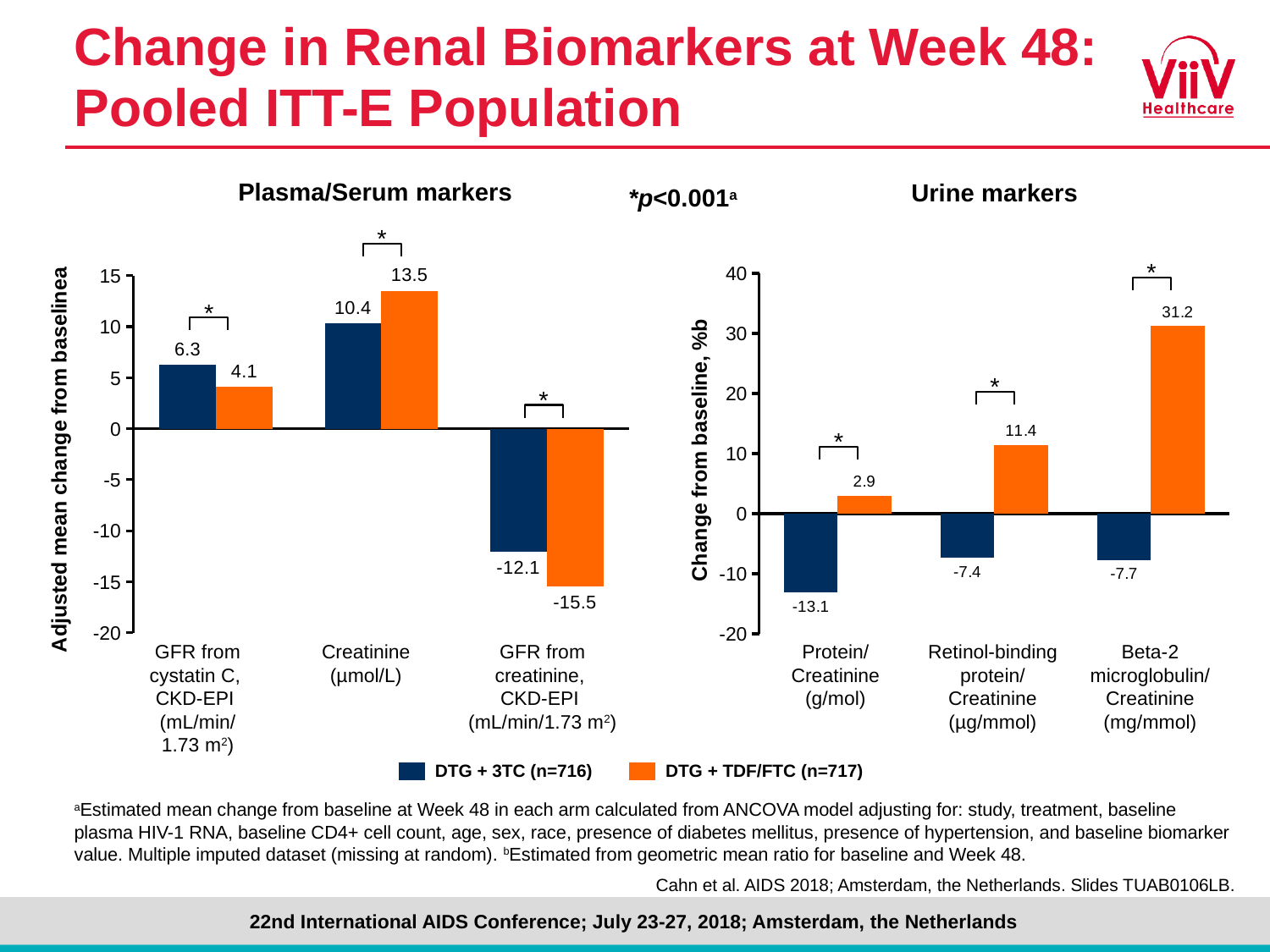
How many markers are shown on the x axis of the Urine markers chart? 3 In the Plasma/Serum markers chart, which marker has the lowest value for the DTG + TDF/FTC arm? GFR from creatinine, CKD-EPI In the Plasma/Serum markers chart, what is the difference between the DTG + TDF/FTC and DTG + 3TC values for creatinine? 3.1 In the Plasma/Serum markers chart, which arm has the larger value for GFR from cystatin C, DTG + 3TC or DTG + TDF/FTC? DTG + 3TC In the Plasma/Serum markers chart, what is the adjusted mean change from baseline in GFR from cystatin C for the DTG + 3TC arm? 6.3 In the Plasma/Serum markers chart, what is the adjusted mean change from baseline in creatinine for the DTG + TDF/FTC arm? 13.5 In the Urine markers chart, what is the difference between the DTG + TDF/FTC and DTG + 3TC values for Retinol-binding protein/Creatinine? 18.8 What type of chart is the Plasma/Serum markers chart? Bar chart How many series does the legend list for the charts on this slide? 2 In the Urine markers chart, what is the change from baseline in Beta-2 microglobulin/Creatinine for the DTG + TDF/FTC arm? 31.2 In the Urine markers chart, what is the change from baseline in Protein/Creatinine for the DTG + 3TC arm? -13.1 In the Urine markers chart, which marker has the highest value for the DTG + TDF/FTC arm? Beta-2 microglobulin/Creatinine